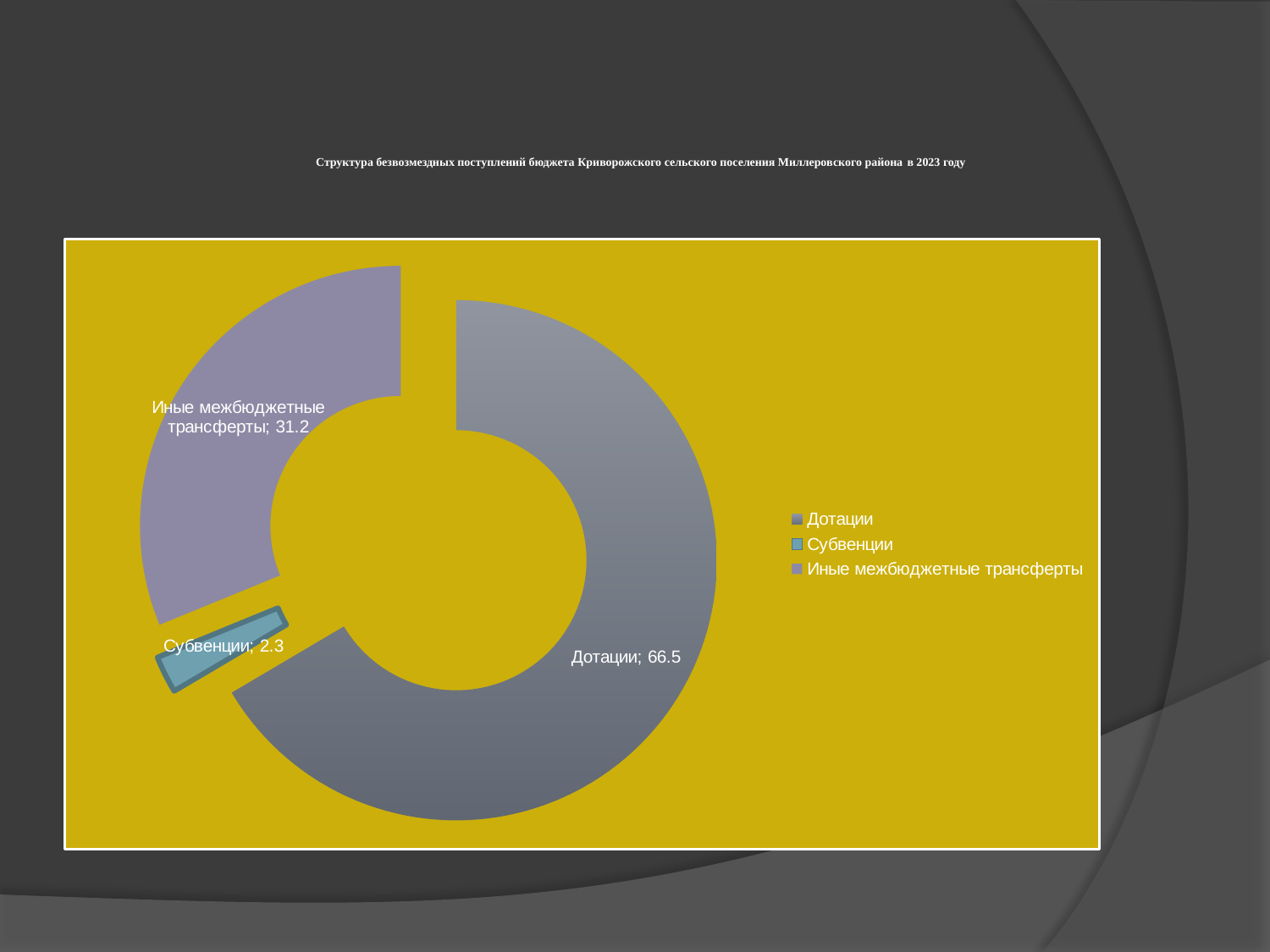
What is the value shown for Иные межбюджетные трансферты? 31.2 What kind of chart is shown on the slide? Doughnut chart How many entries does the legend list? 3 What is the total of the three values shown on the chart? 100 What is the value shown for Субвенции? 2.3 Which category has the largest slice? Дотации Which is larger, Иные межбюджетные трансферты or Субвенции? Иные межбюджетные трансферты How many categories does the chart show? 3 Which category has the smallest slice? Субвенции What is the difference between the values for Дотации and Иные межбюджетные трансферты? 35.3 What is the value shown for Дотации? 66.5 What is the difference between the values for Иные межбюджетные трансферты and Субвенции? 28.9